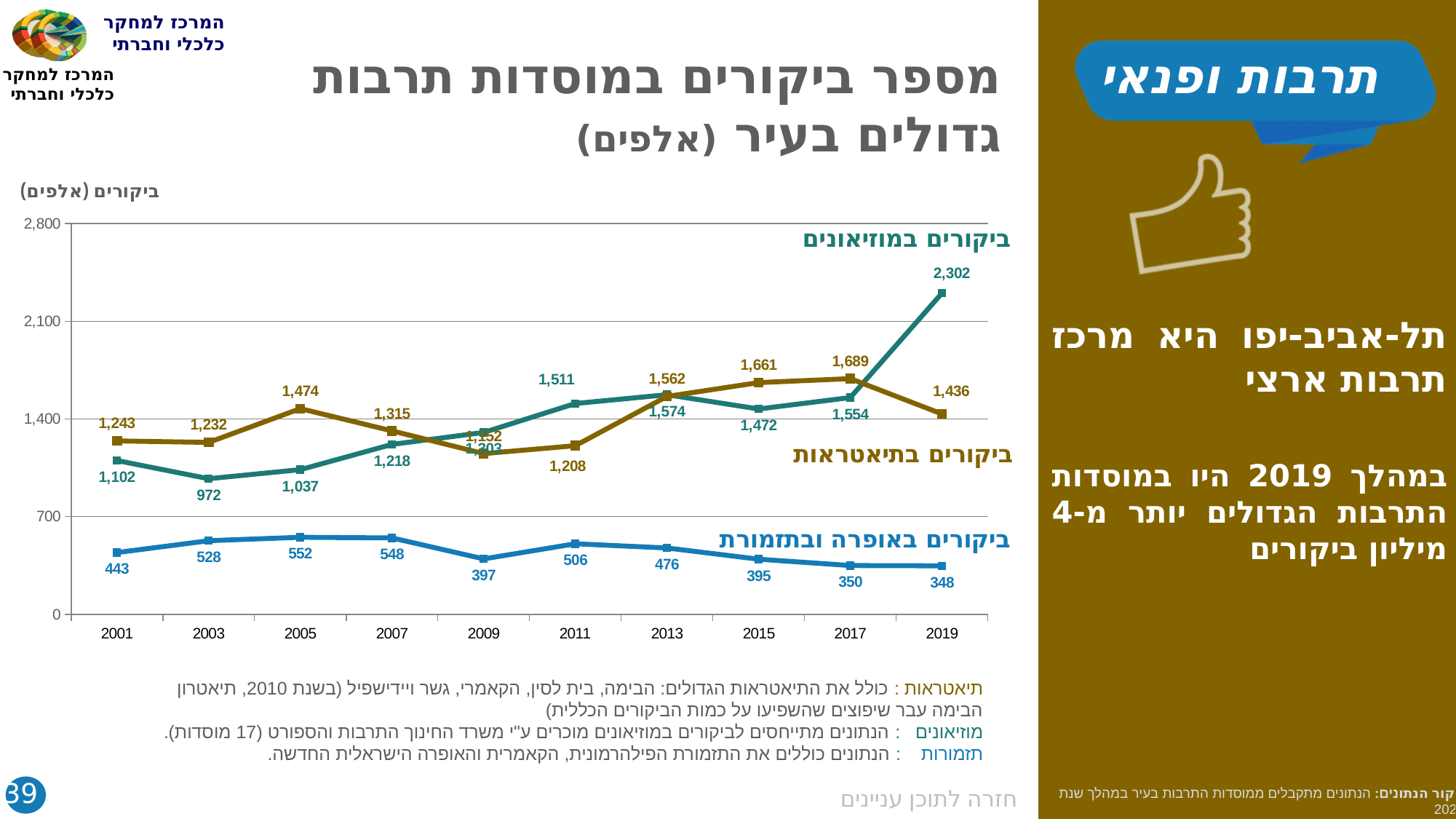
What is the value for opera and orchestra visits (ביקורים באופרה ובתזמורת) in 2005? 552 In which year is the opera and orchestra visits (ביקורים באופרה ובתזמורת) series at its lowest? 2019 What is the value for theater visits (ביקורים בתיאטראות) in 2017? 1,689 Is the value for opera and orchestra visits in 2001 greater or less than 700? less Does the opera and orchestra visits (ביקורים באופרה ובתזמורת) series rise or fall between 2011 and 2019? fall How many years are plotted along the x axis? 10 How many series does the chart show? 3 In which year is the museum visits (ביקורים במוזיאונים) series at its highest? 2019 Which was larger in 2015: museum visits or theater visits? theater visits (ביקורים בתיאטראות) What is the value for museum visits (ביקורים במוזיאונים) in 2019? 2,302 What type of chart is shown on the slide? line chart What is the difference between museum visits and theater visits in 2019? 866